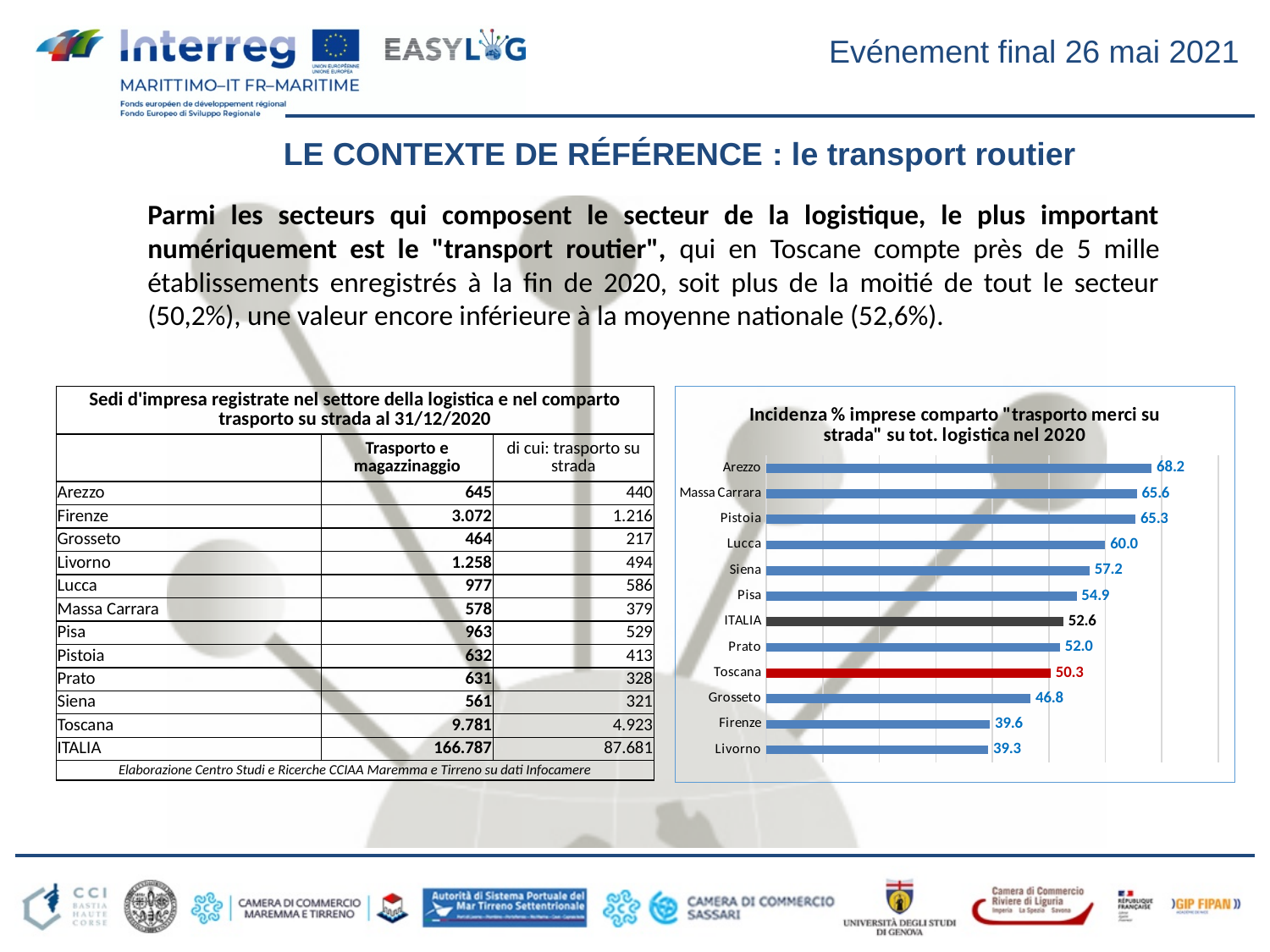
What is the value for ITALIA in the chart? 52.6 What is the difference between the values for Arezzo and Livorno? 28.9 Which has a larger value, Lucca or Pisa? Lucca Which category's bar is coloured red in the chart? Toscana What is the value for Toscana in the chart? 50.3 What is the difference between the values for ITALIA and Toscana? 2.3 What is the value for Livorno in the chart? 39.3 What is the value for Arezzo in the chart? 68.2 What type of chart is shown on the slide? bar chart Which category has the highest value in the chart? Arezzo How many categories are plotted in the chart? 12 Which category has the lowest value in the chart? Livorno